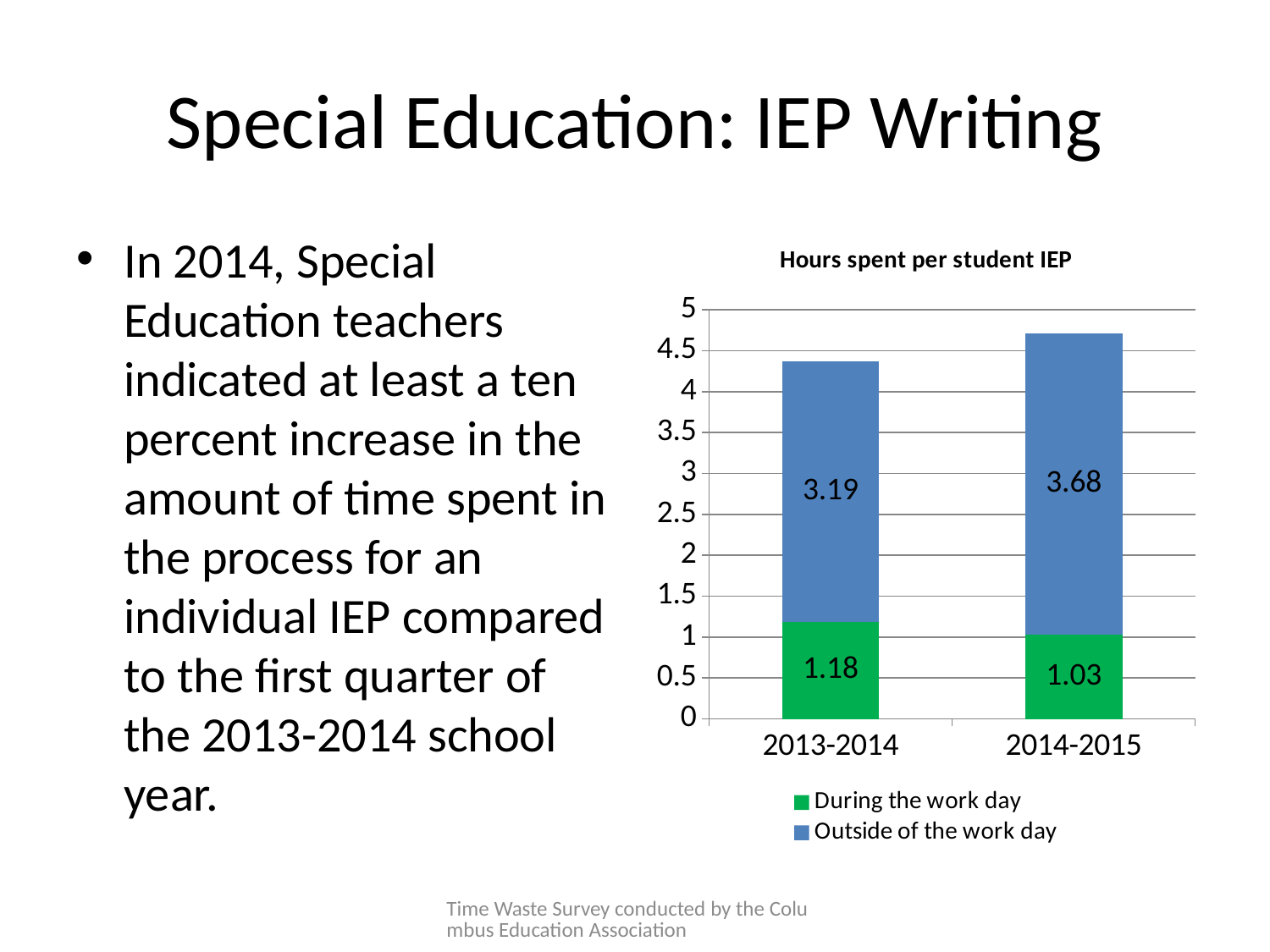
What is the value for 'Outside of the work day' in 2014-2015? 3.68 What is the total of the stacked bar for 2014-2015? 4.71 Which year has the higher 'Outside of the work day' value? 2014-2015 What is the title of the chart? Hours spent per student IEP What is the value for 'During the work day' in 2014-2015? 1.03 What kind of chart is shown? Stacked bar chart What is the value for 'Outside of the work day' in 2013-2014? 3.19 What is the value for 'During the work day' in 2013-2014? 1.18 Which year has the higher 'During the work day' value? 2013-2014 What is the total of the stacked bar for 2013-2014? 4.37 What is the difference between the 'Outside of the work day' values for 2014-2015 and 2013-2014? 0.49 How many series does the legend list? 2